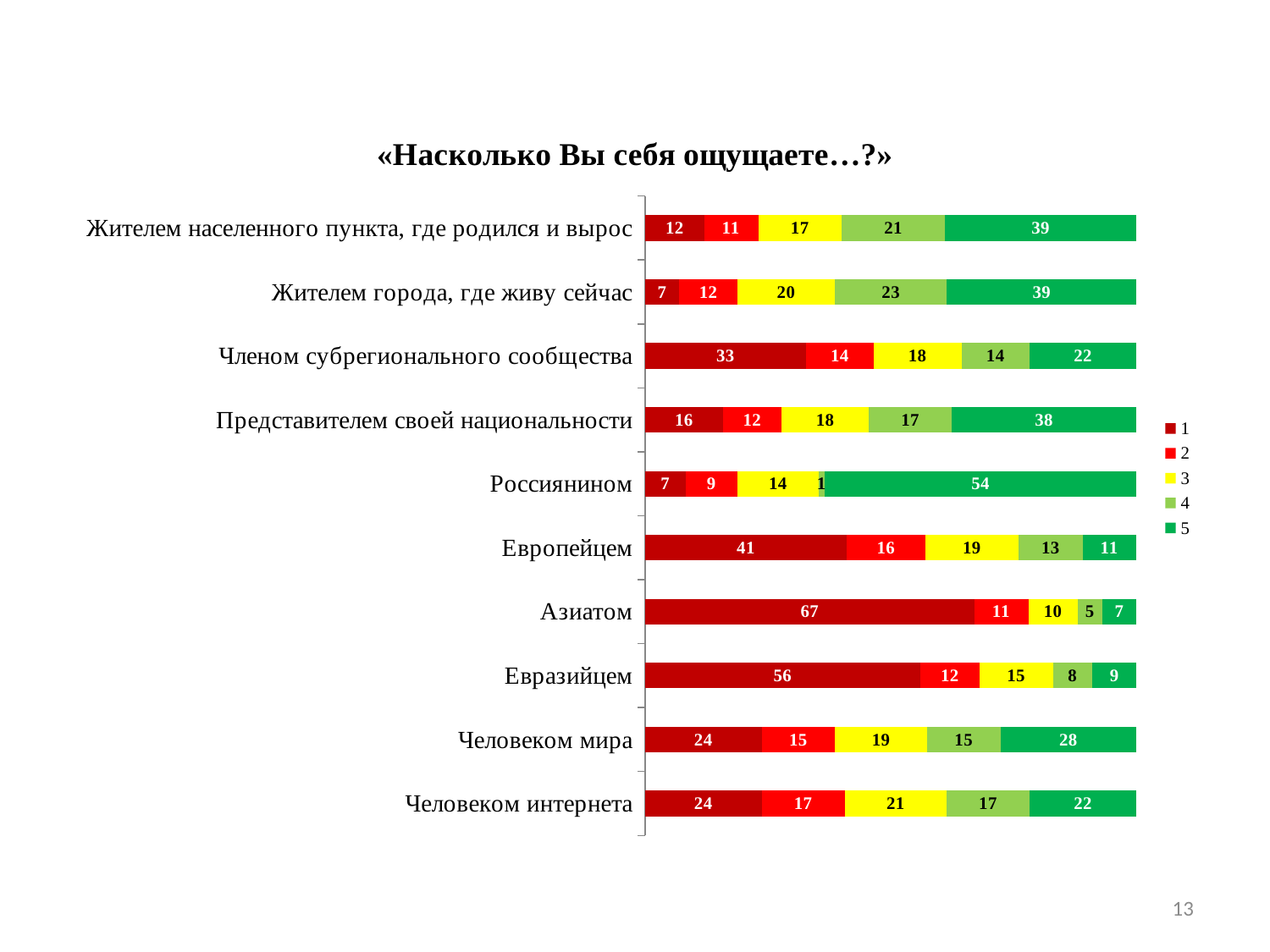
Which has the larger series 5 value: "Человеком мира" or "Человеком интернета"? Человеком мира What is the difference between series 1 and series 5 for "Европейцем"? 30 How many categories (rows) does the chart show? 10 What is the value of series 3 for "Членом субрегионального сообщества"? 18 How many series does the legend list? 5 What is the value of series 1 for "Азиатом"? 67 What is the value of series 5 for "Россиянином"? 54 What is the value of series 2 for "Евразийцем"? 12 What kind of chart is shown on the slide? Stacked bar chart Which category has the lowest value for series 5? Азиатом Which category has the highest value for series 1? Азиатом What is the title of the chart? «Насколько Вы себя ощущаете…?»